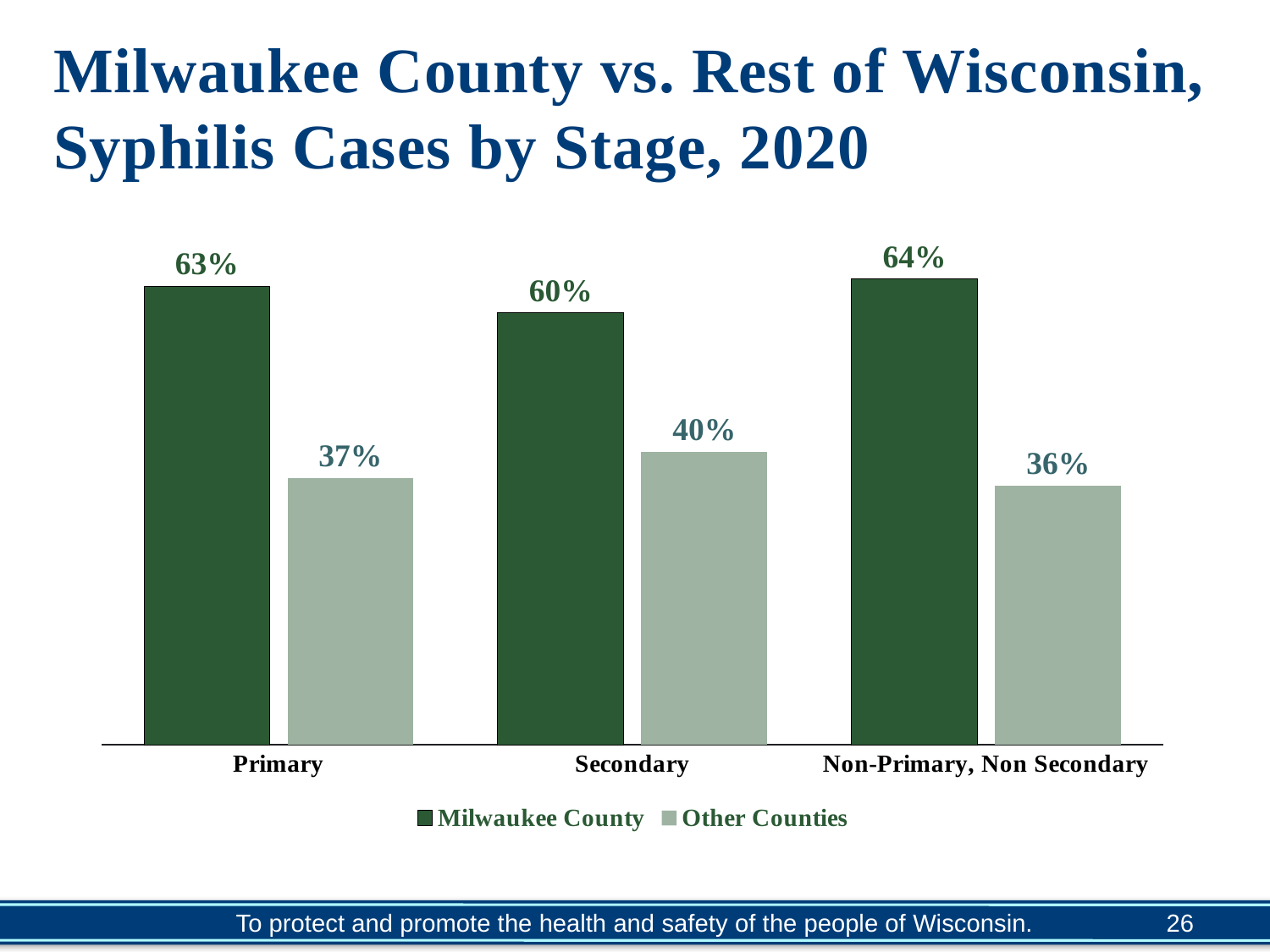
What is the value for Other Counties in the Secondary stage? 40% How many series does the legend list? 2 What is the title of the slide? Milwaukee County vs. Rest of Wisconsin, Syphilis Cases by Stage, 2020 What kind of chart is shown on the slide? Bar chart How many stage categories are shown on the x axis? 3 In the Primary stage, which is larger: Milwaukee County or Other Counties? Milwaukee County Which stage has the lowest value for Other Counties? Non-Primary, Non Secondary What is the value for Milwaukee County in the Primary stage? 63% What is the value for Milwaukee County in the Non-Primary, Non Secondary stage? 64% Which stage has the highest value for Milwaukee County? Non-Primary, Non Secondary What is the value for Other Counties in the Primary stage? 37% What is the difference between the Milwaukee County and Other Counties values in the Secondary stage? 20%